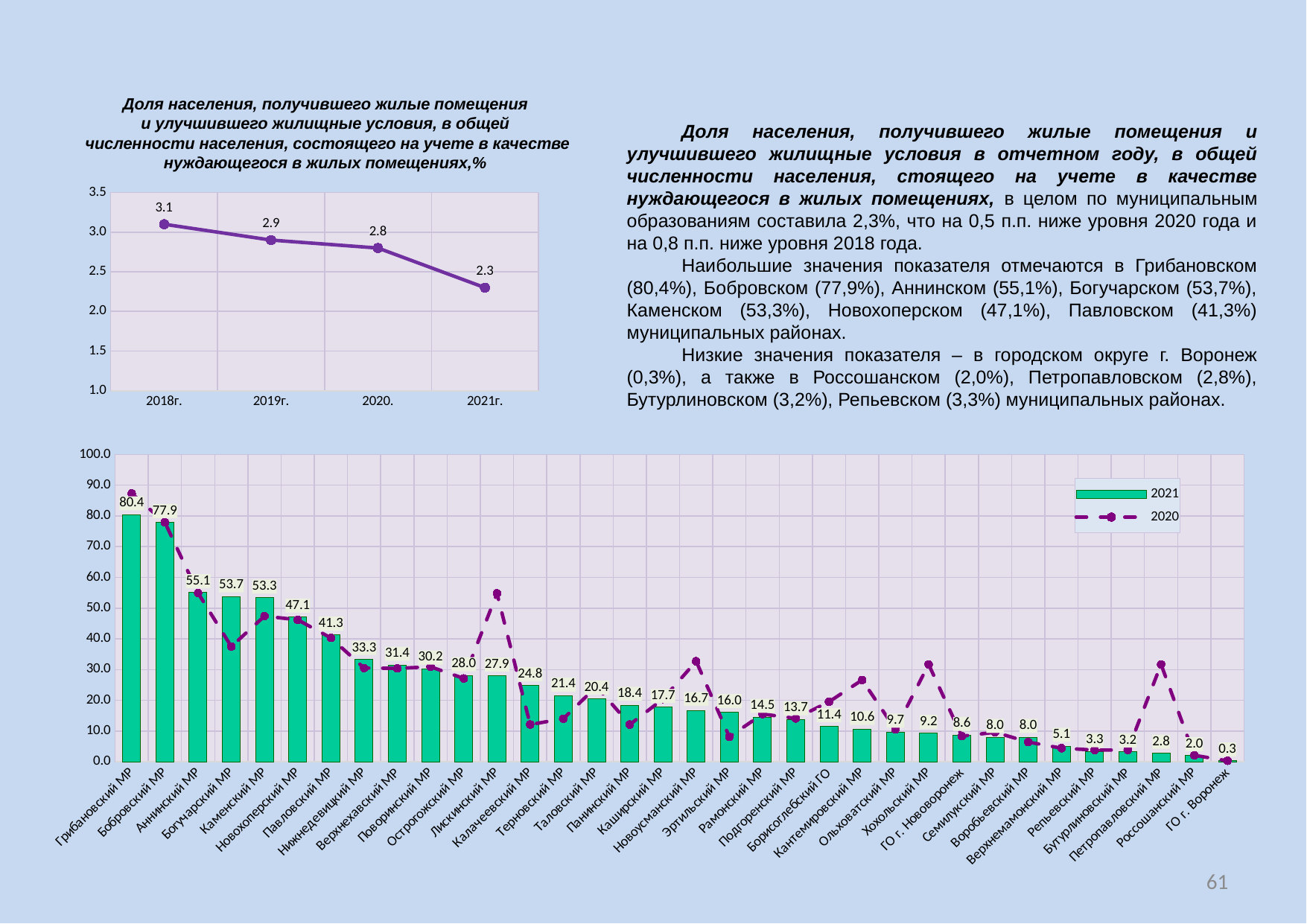
In the bottom bar chart, which has a larger 2021 value, Каширский МР or Рамонский МР? Каширский МР In the bottom bar chart, what is the 2021 value for Богучарский МР? 53.7 In the top-left line chart, what is the value for 2018г.? 3.1 In the bottom bar chart, how many categories are shown on the x axis? 34 In the bottom bar chart, what is the 2021 value for Лискинский МР? 27.9 In the bottom bar chart, which category has the highest 2021 value? Грибановский МР In the bottom bar chart, which category has the lowest 2021 value? ГО г. Воронеж In the bottom bar chart, how many series does the legend list? 2 In the top-left line chart, what is the value for 2021г.? 2.3 In the top-left line chart, do the values rise or fall from 2018г. to 2021г.? fall In the bottom bar chart, is the 2020 value for Лискинский МР greater or less than 50? greater In the top-left line chart, what is the difference between the 2018г. and 2021г. values? 0.8